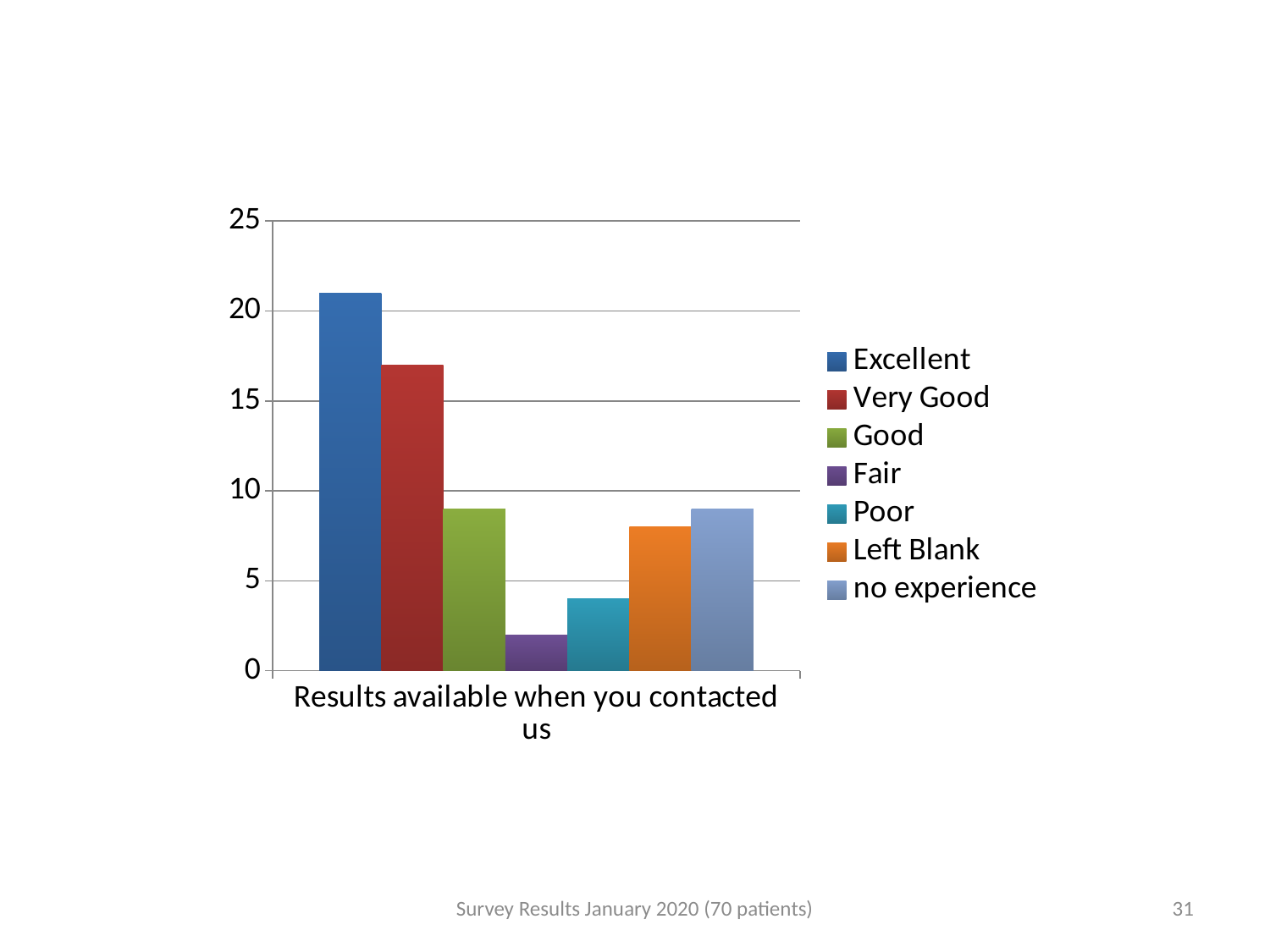
Is the value for Excellent greater or less than 20? greater How many series does the legend list? 7 Is the value for Good greater or less than 10? less Which is larger, the value for Poor or the value for Fair? Poor Is the value for Poor greater or less than 5? less Which series has the lowest value? Fair What kind of chart is shown on the slide? bar chart Which is larger, the value for Very Good or the value for Left Blank? Very Good Which series has the highest value? Excellent What is the category label shown on the x axis? Results available when you contacted us